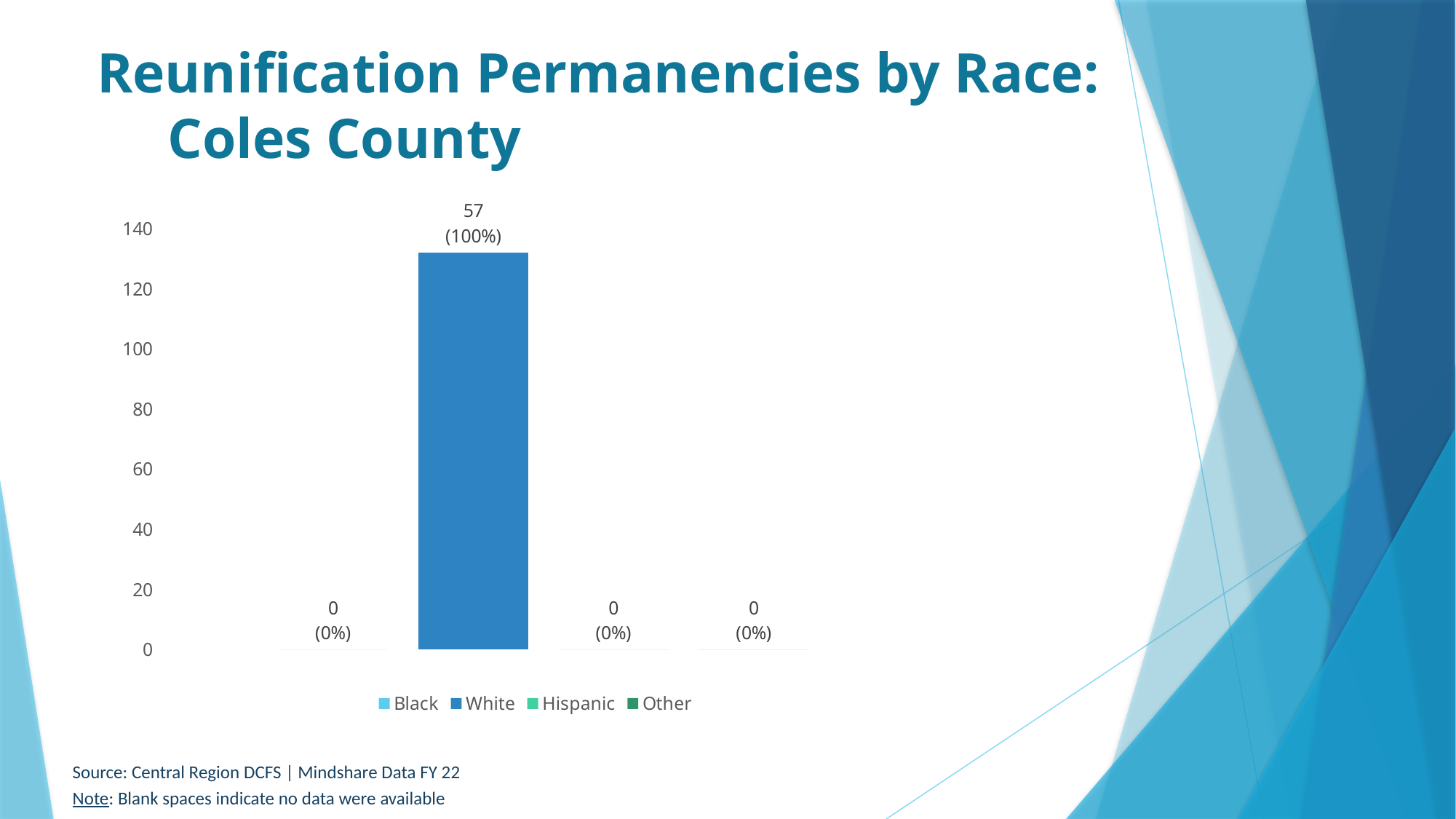
What is the value for Hispanic? 0 What is the source cited for the chart data? Central Region DCFS | Mindshare Data FY 22 Which category has the highest value? White What percentage is shown for Other? 0% What is the value for White? 57 How many categories does the legend list? 4 Which is larger, the value for White or the value for Hispanic? White What is the difference between the values for White and Black? 57 What is the value for Black? 0 What kind of chart is shown on the slide? Bar chart What percentage is shown for White? 100% What is the title of the slide? Reunification Permanencies by Race: Coles County